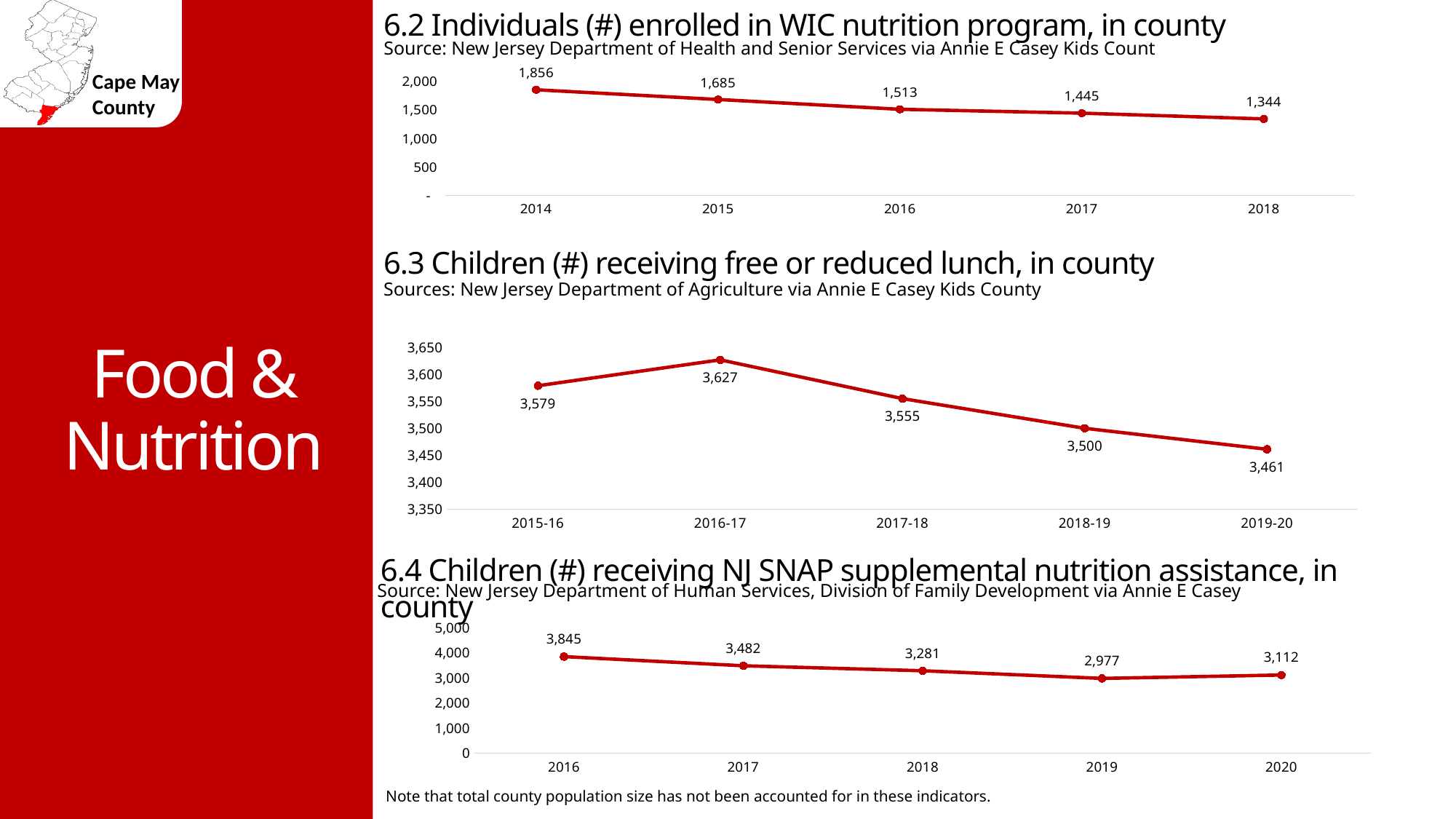
In the chart '6.2 Individuals (#) enrolled in WIC nutrition program, in county', which year has the highest value? 2014 In the chart '6.2 Individuals (#) enrolled in WIC nutrition program, in county', what is the value for 2016? 1,513 In the chart '6.4 Children (#) receiving NJ SNAP supplemental nutrition assistance, in county', what is the value for 2019? 2,977 What kind of chart is the chart '6.4 Children (#) receiving NJ SNAP supplemental nutrition assistance, in county'? line chart In the chart '6.3 Children (#) receiving free or reduced lunch, in county', how many data points are plotted? 5 In the chart '6.2 Individuals (#) enrolled in WIC nutrition program, in county', do the values rise or fall from 2014 to 2018? fall In the chart '6.3 Children (#) receiving free or reduced lunch, in county', what is the value for 2016-17? 3,627 In the chart '6.2 Individuals (#) enrolled in WIC nutrition program, in county', what is the difference between the 2014 and 2018 values? 512 In the chart '6.3 Children (#) receiving free or reduced lunch, in county', which school year has the lowest value? 2019-20 In the chart '6.4 Children (#) receiving NJ SNAP supplemental nutrition assistance, in county', what is the difference between the 2016 and 2017 values? 363 In the chart '6.4 Children (#) receiving NJ SNAP supplemental nutrition assistance, in county', is the value for 2018 greater or less than 3,000? greater In the chart '6.3 Children (#) receiving free or reduced lunch, in county', which is larger, the value for 2015-16 or the value for 2018-19? 2015-16